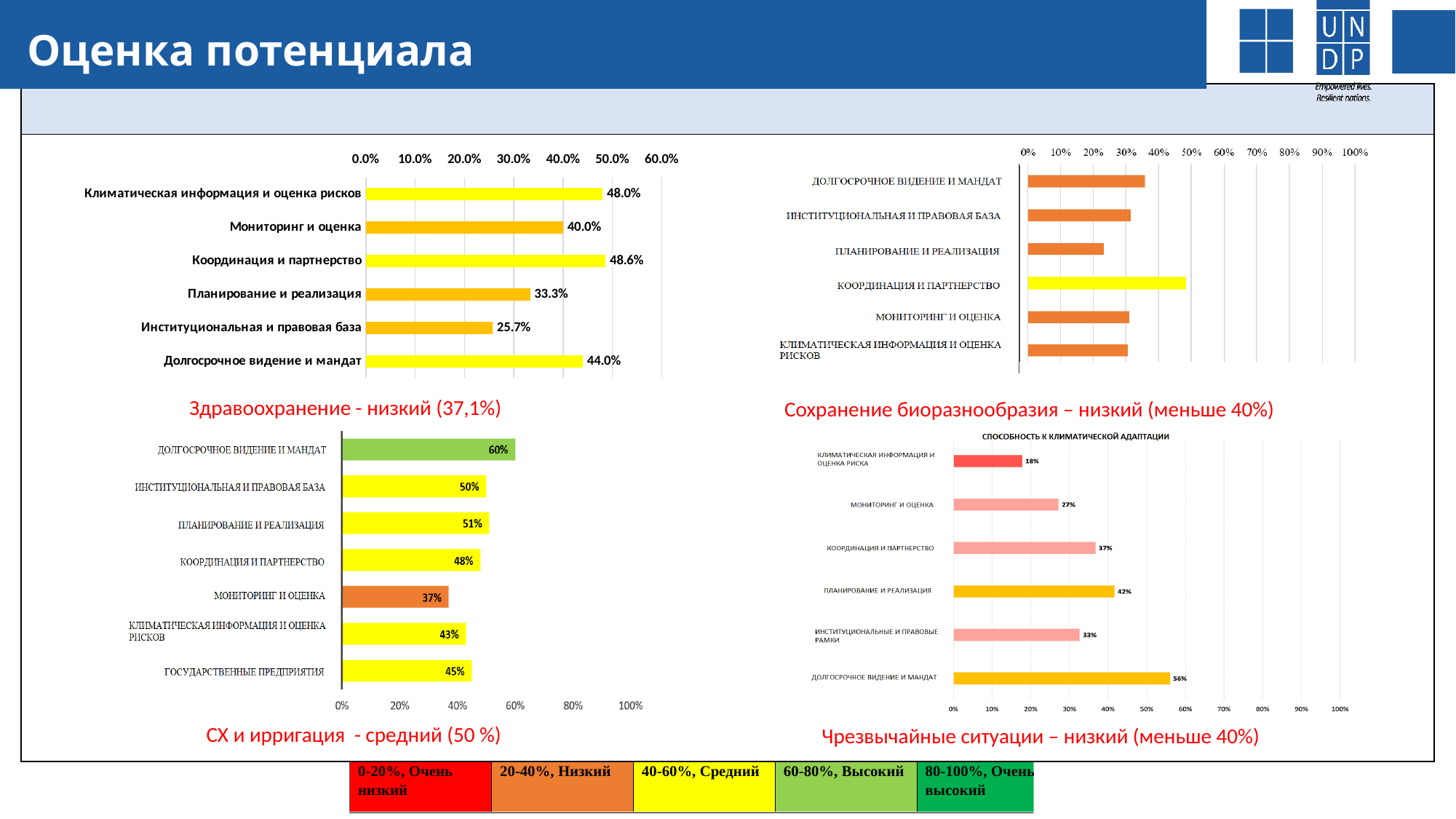
In the 'Чрезвычайные ситуации' chart (bottom right), what is the value for Климатическая информация и оценка риска? 18% In the 'СХ и ирригация' chart (bottom left), what is the value for Мониторинг и оценка? 37% In the 'Здравоохранение' chart (top left), what is the difference between Долгосрочное видение и мандат and Планирование и реализация? 10.7% In the 'Здравоохранение' chart (top left), which category has the lowest value? Институциональная и правовая база In the 'Сохранение биоразнообразия' chart (top right), is the value for Планирование и реализация greater or less than 30%? less In the 'Здравоохранение' chart (top left), what is the value for Координация и партнерство? 48.6% In the 'СХ и ирригация' chart (bottom left), how many categories are plotted? 7 In the 'СХ и ирригация' chart (bottom left), which category has the highest value? Долгосрочное видение и мандат In the 'Здравоохранение' chart (top left), how many categories are plotted? 6 In the 'Сохранение биоразнообразия' chart (top right), which category has the highest value? Координация и партнерство In the 'Чрезвычайные ситуации' chart (bottom right), which is larger: Планирование и реализация or Институциональные и правовые рамки? Планирование и реализация What type of chart is the 'Чрезвычайные ситуации' chart (bottom right)? Bar chart